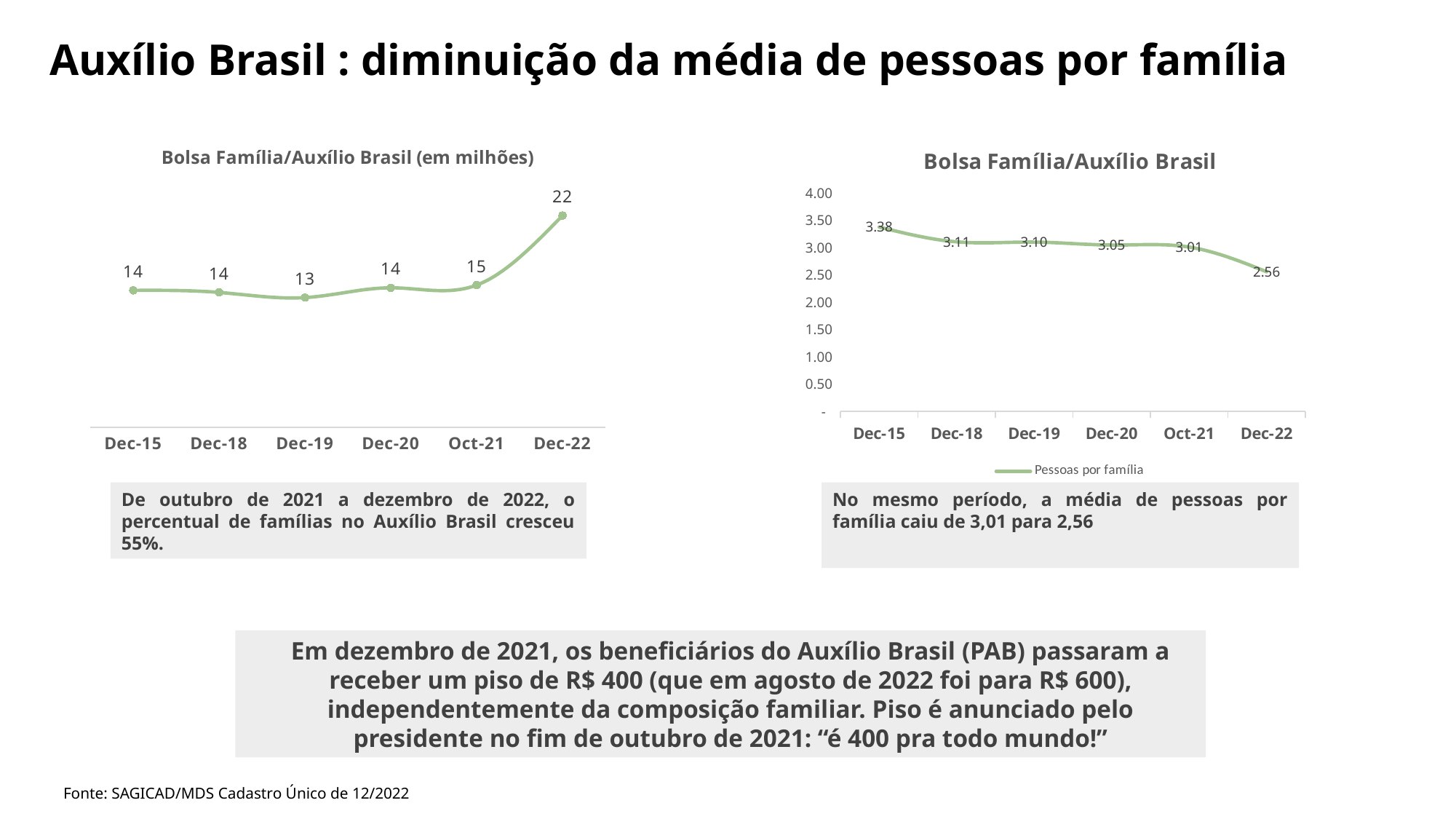
In the left chart 'Bolsa Família/Auxílio Brasil (em milhões)', what is the value for Dec-22? 22 What kind of chart is the right chart 'Bolsa Família/Auxílio Brasil'? line chart In the left chart 'Bolsa Família/Auxílio Brasil (em milhões)', which period has the lowest value? Dec-19 In the right chart 'Bolsa Família/Auxílio Brasil', which period has the lowest value? Dec-22 In the right chart 'Bolsa Família/Auxílio Brasil', do the values rise or fall from Dec-15 to Dec-22? fall In the left chart 'Bolsa Família/Auxílio Brasil (em milhões)', which period has the highest value? Dec-22 In the left chart 'Bolsa Família/Auxílio Brasil (em milhões)', how many data points are plotted? 6 In the left chart 'Bolsa Família/Auxílio Brasil (em milhões)', what is the value for Dec-19? 13 In the right chart 'Bolsa Família/Auxílio Brasil', what is the difference between the Oct-21 value and the Dec-22 value? 0.45 In the right chart 'Bolsa Família/Auxílio Brasil', what is the value for Dec-15? 3.38 In the right chart 'Bolsa Família/Auxílio Brasil', what is the value for Dec-22? 2.56 In the left chart 'Bolsa Família/Auxílio Brasil (em milhões)', what is the difference between the Dec-22 value and the Oct-21 value? 7